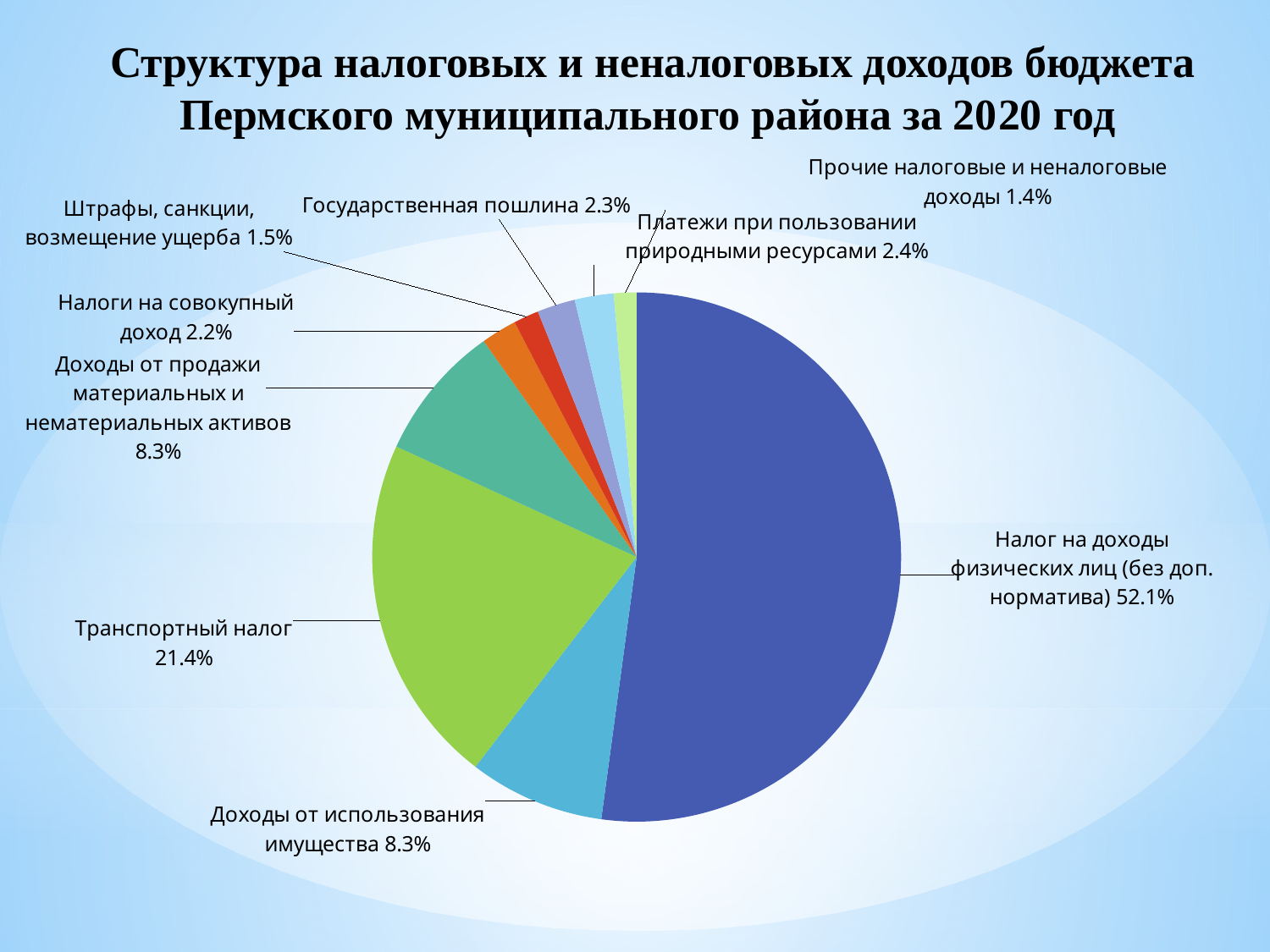
What is the value shown for "Доходы от использования имущества"? 8.3% What is the title of the slide? Структура налоговых и неналоговых доходов бюджета Пермского муниципального района за 2020 год What is the value shown for "Транспортный налог"? 21.4% What type of chart is shown on the slide? Pie chart How many slices does the pie chart have? 9 Which is larger: "Государственная пошлина" or "Налоги на совокупный доход"? Государственная пошлина What share of the pie does "Налог на доходы физических лиц (без доп. норматива)" have? 52.1% Which category has the smallest share of the pie? Прочие налоговые и неналоговые доходы Which category has the largest share of the pie? Налог на доходы физических лиц (без доп. норматива) What is the value shown for "Платежи при пользовании природными ресурсами"? 2.4% What is the value shown for "Штрафы, санкции, возмещение ущерба"? 1.5% What is the difference between the shares of "Налог на доходы физических лиц (без доп. норматива)" and "Транспортный налог"? 30.7%